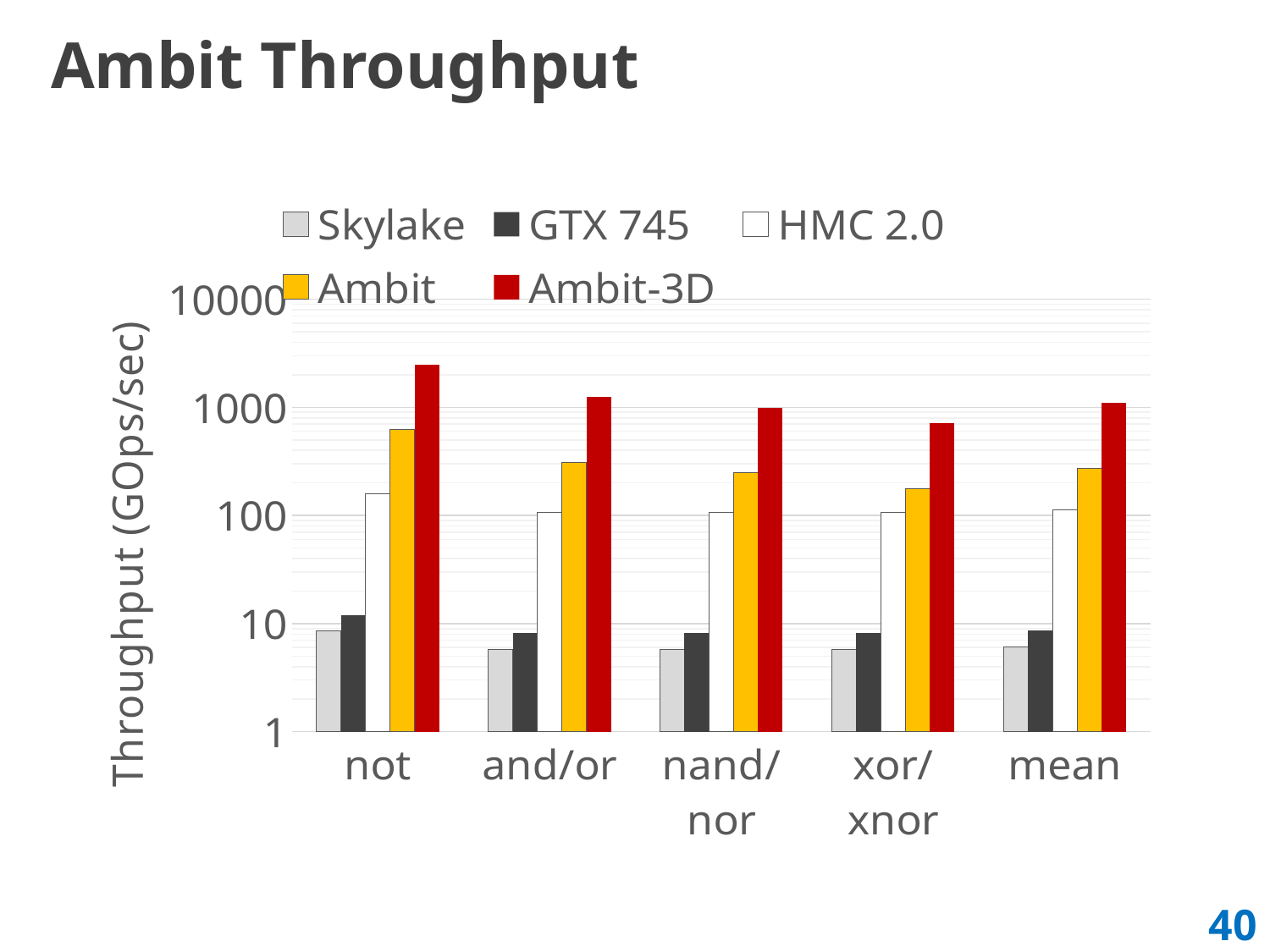
Which series has the lowest value for the "not" category? Skylake Which series has the highest value for the "not" category? Ambit-3D Is the Ambit value for "not" greater or less than 1000? less What kind of chart is shown on the slide? bar chart For which category is the Ambit-3D value lowest? xor/xnor Is the Skylake value for "not" greater or less than 10? less For the "mean" category, which is larger: the Ambit value or the HMC 2.0 value? Ambit How many categories are shown on the x axis? 5 How many series does the legend list? 5 For which category is the Ambit-3D value highest? not What is the label of the y axis? Throughput (GOps/sec) Is the Ambit-3D value for "not" greater or less than 1000? greater